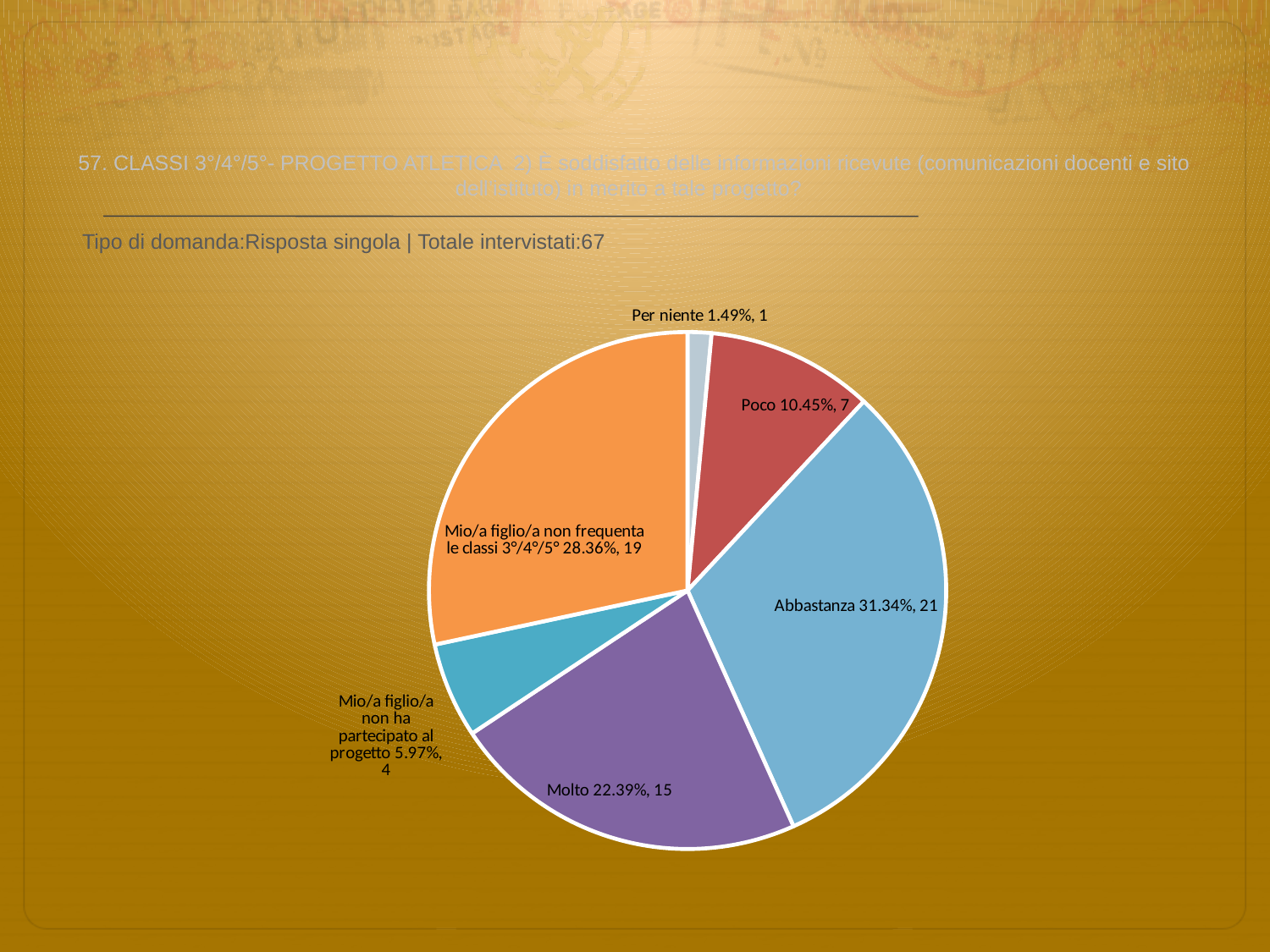
How many respondents answered 'Molto'? 15 What percentage share does the 'Abbastanza' slice have? 31.34% What is the total number of respondents across all slices? 67 Which category has the smallest slice? Per niente What percentage share does 'Mio/a figlio/a non ha partecipato al progetto' have? 5.97% What is the count for 'Poco'? 7 How many slices does the pie chart have? 6 What colour is the 'Molto' slice? purple Which category has the largest slice? Abbastanza What kind of chart is shown on the slide? pie chart What is the difference in count between 'Abbastanza' and 'Molto'? 6 Which is larger, the count for 'Mio/a figlio/a non frequenta le classi 3°/4°/5°' or the count for 'Molto'? Mio/a figlio/a non frequenta le classi 3°/4°/5°